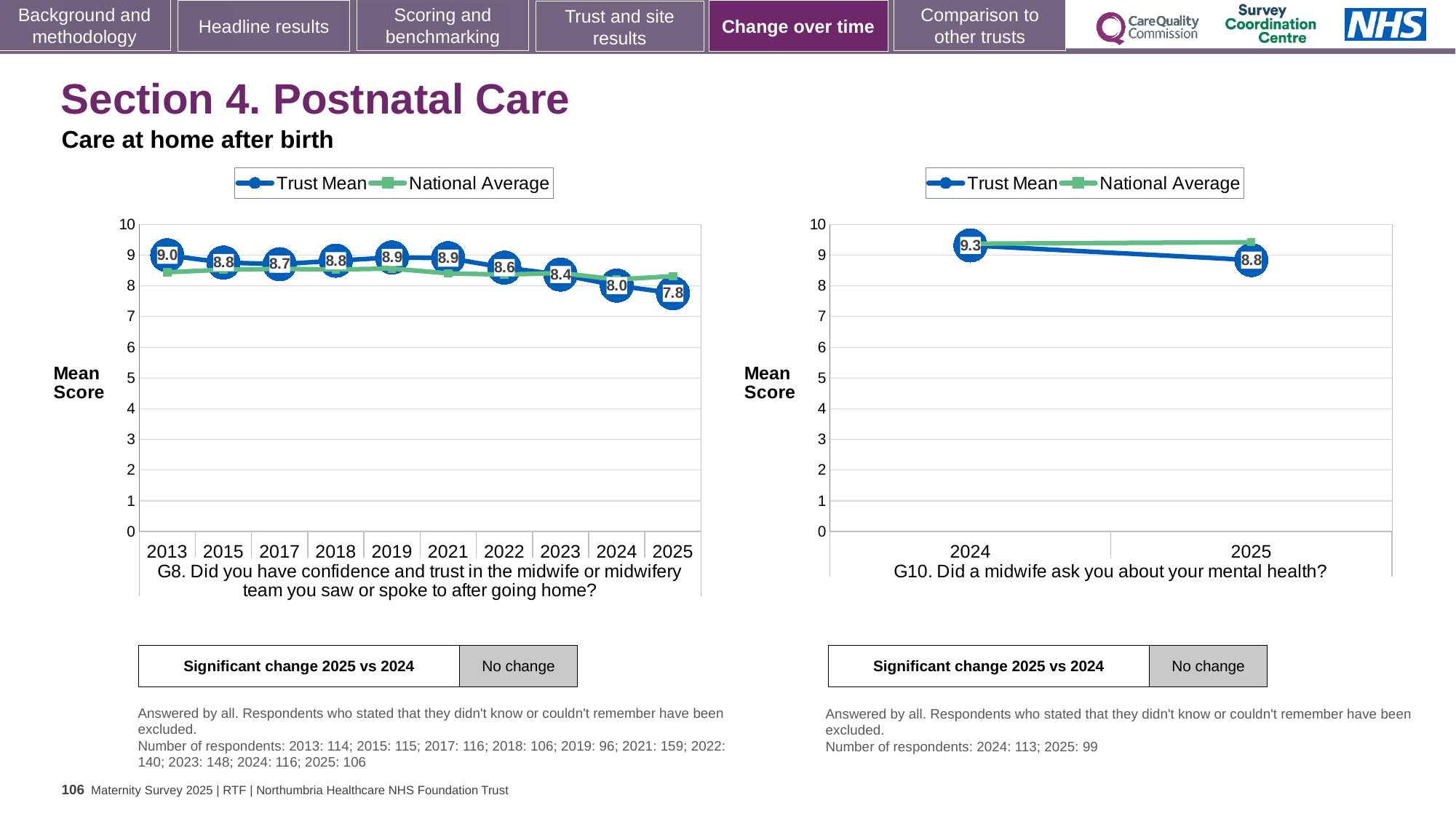
On the G8 chart (left), what is the difference between the Trust Mean in 2013 and in 2025? 1.2 On the G8 chart (left), what is the Trust Mean for 2025? 7.8 On the G8 chart (left), how many years are shown on the x axis? 10 On the G10 chart (right), what is the difference between the Trust Mean in 2024 and in 2025? 0.5 On the G10 chart (right), is the Trust Mean for 2025 greater or less than 9? less On the G8 chart (left), what is the Trust Mean for 2013? 9.0 On the G8 chart (left), which year has the lowest Trust Mean? 2025 On the G8 chart (left), which year has the highest Trust Mean? 2013 On the G8 chart (left), does the Trust Mean generally rise or fall from 2013 to 2025? fall How many series does the legend of the G10 chart (right) list? 2 On the G10 chart (right), what is the Trust Mean for 2024? 9.3 On the G8 chart (left), what is the Trust Mean for 2022? 8.6